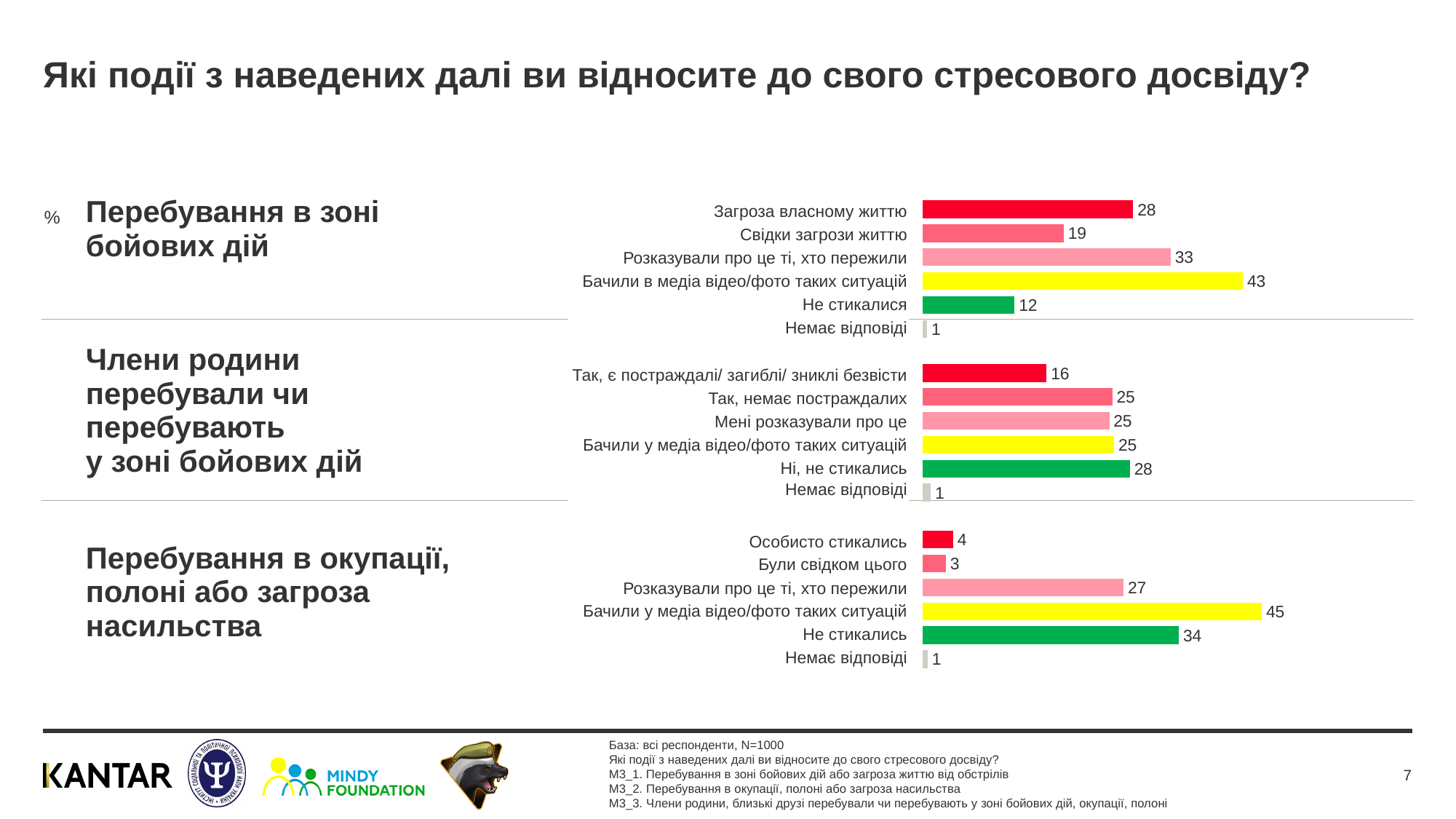
In the chart 'Члени родини перебували чи перебувають у зоні бойових дій', how many categories are shown? 6 In the chart 'Перебування в зоні бойових дій', what is the difference between 'Розказували про це ті, хто пережили' and 'Свідки загрози життю'? 14 In the chart 'Перебування в зоні бойових дій', which category has the highest value? Бачили в медіа відео/фото таких ситуацій In the chart 'Члени родини перебували чи перебувають у зоні бойових дій', which category has the highest value? Ні, не стикались In the chart 'Перебування в зоні бойових дій', what colour is the bar for 'Бачили в медіа відео/фото таких ситуацій'? Yellow In the chart 'Перебування в окупації, полоні або загроза насильства', what is the value for 'Не стикались'? 34 In the chart 'Перебування в окупації, полоні або загроза насильства', which is larger: 'Особисто стикались' or 'Були свідком цього'? Особисто стикались In the chart 'Перебування в окупації, полоні або загроза насильства', which category has the lowest value? Немає відповіді In the chart 'Члени родини перебували чи перебувають у зоні бойових дій', what is the value for 'Так, є постраждалі/ загиблі/ зниклі безвісти'? 16 In the chart 'Перебування в зоні бойових дій', what is the value for 'Загроза власному життю'? 28 What type of chart is used on this slide? Bar chart In the chart 'Перебування в окупації, полоні або загроза насильства', what is the difference between 'Бачили у медіа відео/фото таких ситуацій' and 'Розказували про це ті, хто пережили'? 18